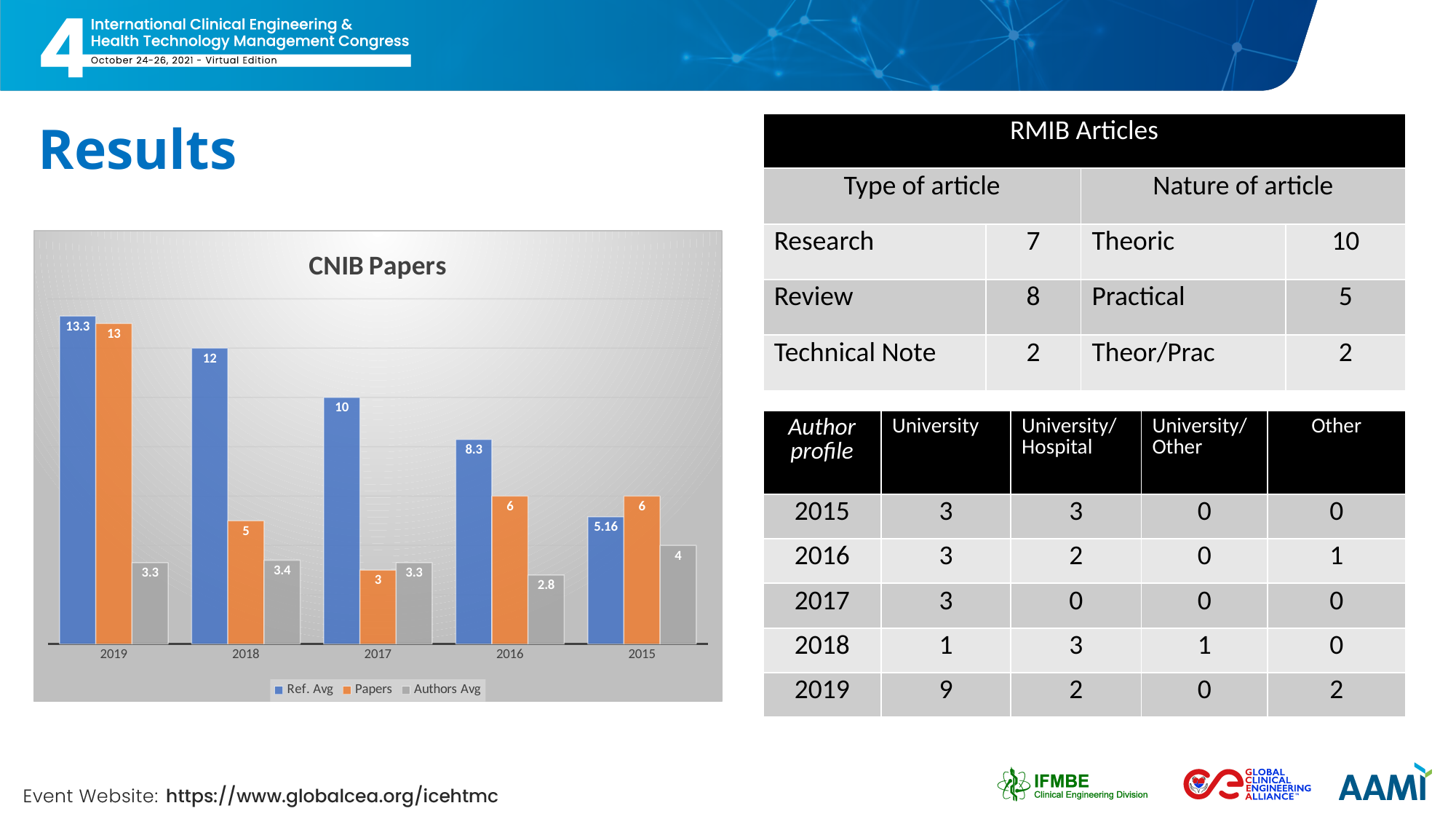
What is the Papers value for 2018 in the CNIB Papers chart? 5 Which year has the highest Papers value in the CNIB Papers chart? 2019 How many years are shown on the x axis of the CNIB Papers chart? 5 What is the Ref. Avg value for 2019 in the CNIB Papers chart? 13.3 In the CNIB Papers chart, which is larger for 2017: the Ref. Avg value or the Papers value? Ref. Avg What kind of chart is the CNIB Papers chart? bar chart Does the Ref. Avg series rise or fall from left to right along the x axis of the CNIB Papers chart? fall What is the Authors Avg value for 2016 in the CNIB Papers chart? 2.8 What is the difference between the Ref. Avg values for 2019 and 2018 in the CNIB Papers chart? 1.3 What is the Ref. Avg value for 2015 in the CNIB Papers chart? 5.16 Which year has the lowest Authors Avg value in the CNIB Papers chart? 2016 How many series does the legend of the CNIB Papers chart list? 3